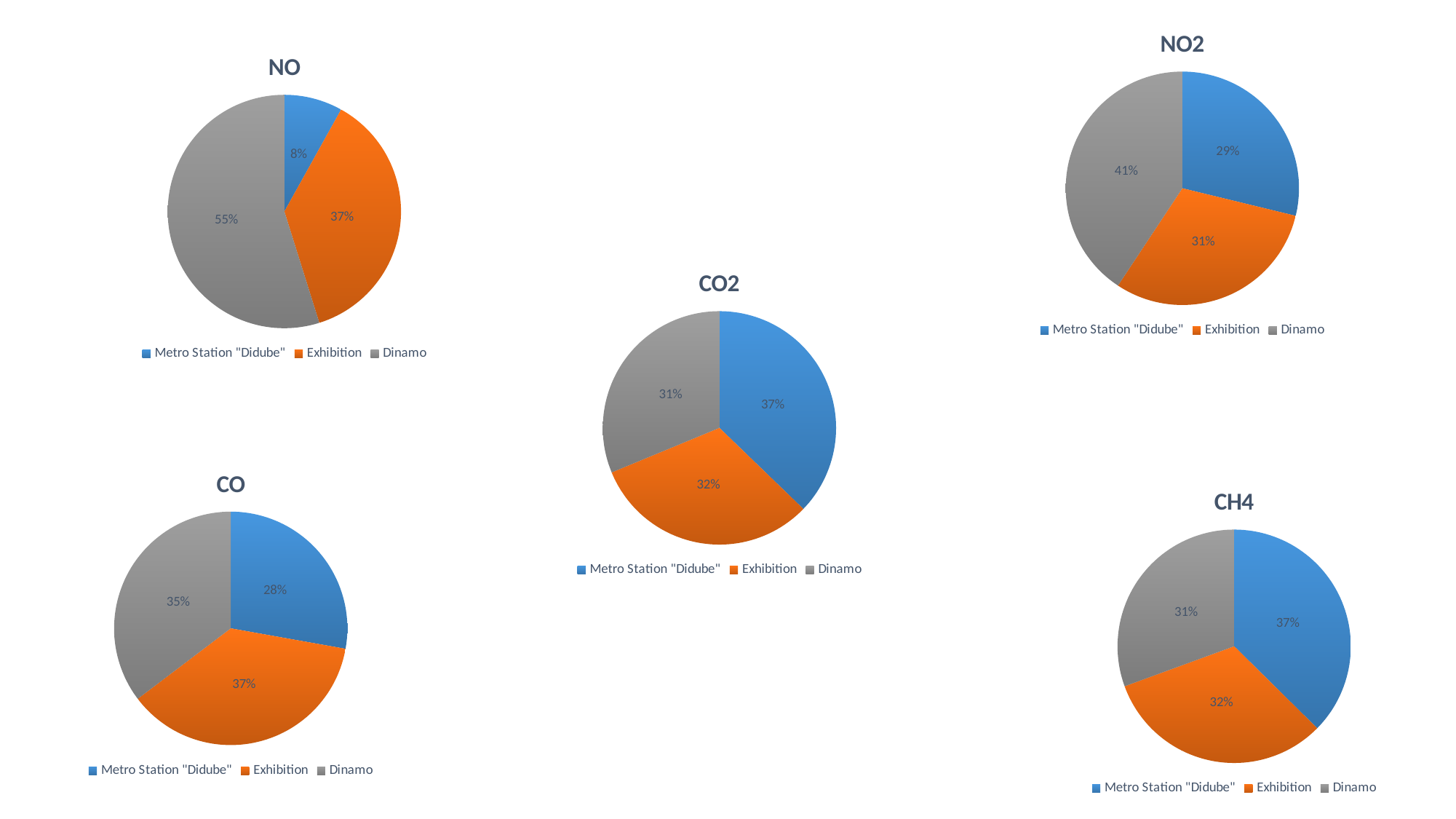
In the NO2 chart, which category has the largest slice? Dinamo In the CO2 chart, which category has the smallest slice? Dinamo How many charts are on the slide? 5 In the CO chart, which is larger, Dinamo or Metro Station "Didube"? Dinamo What kind of chart is the CO2 chart? Pie chart In the CO chart, what is the difference between the Exhibition and Metro Station "Didube" shares? 9% In the CH4 chart, what is the value for Exhibition? 32% How many slices does the NO pie chart have? 3 In the NO2 chart, what is the value for Exhibition? 31% In the NO chart, what share of the pie does Dinamo have? 55% In the NO chart, what is the value for Metro Station "Didube"? 8% In the CH4 chart, what is the value for Metro Station "Didube"? 37%